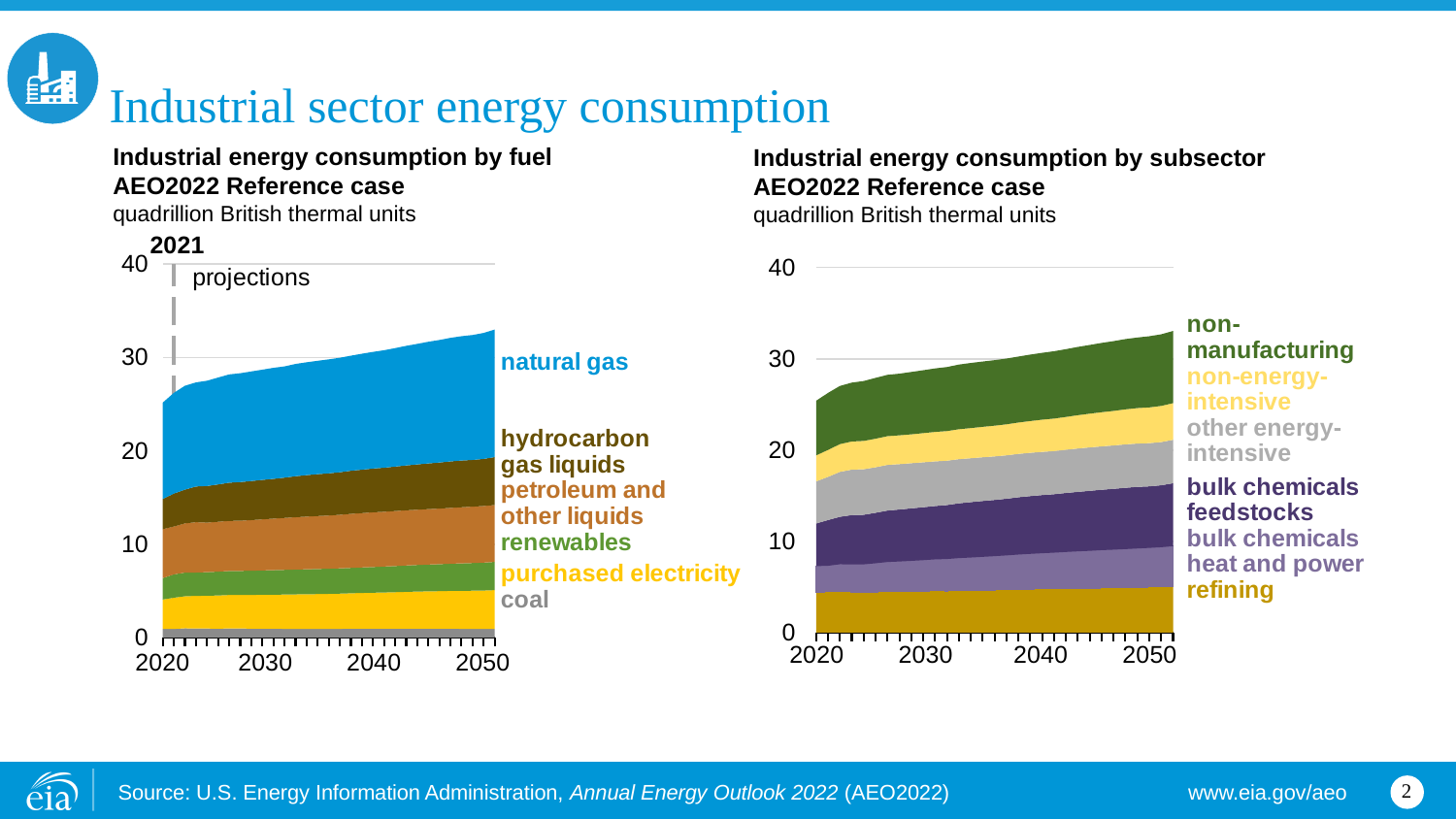
In the left chart, 'Industrial energy consumption by fuel', is total consumption in 2050 greater or less than 30 quadrillion British thermal units? greater In the left chart, 'Industrial energy consumption by fuel', is total consumption in 2020 greater or less than 30 quadrillion British thermal units? less How many fuel series are shown in the left chart, 'Industrial energy consumption by fuel'? 6 In the left chart, 'Industrial energy consumption by fuel', which year does the dashed vertical line mark as the start of projections? 2021 In the right chart, 'Industrial energy consumption by subsector', does total consumption rise or fall from 2020 to 2050? rise In the left chart, 'Industrial energy consumption by fuel', which fuel accounts for the smallest share of consumption? coal In the left chart, 'Industrial energy consumption by fuel', does total industrial energy consumption rise or fall from 2020 to 2050? rise In the left chart, 'Industrial energy consumption by fuel', which fuel accounts for the largest share of consumption? natural gas How many subsector series are shown in the right chart, 'Industrial energy consumption by subsector'? 6 What unit of measurement is used on the y axis of both charts? quadrillion British thermal units What kind of chart is the left chart, 'Industrial energy consumption by fuel'? stacked area chart In the right chart, 'Industrial energy consumption by subsector', is total consumption in 2050 greater or less than 30 quadrillion British thermal units? greater